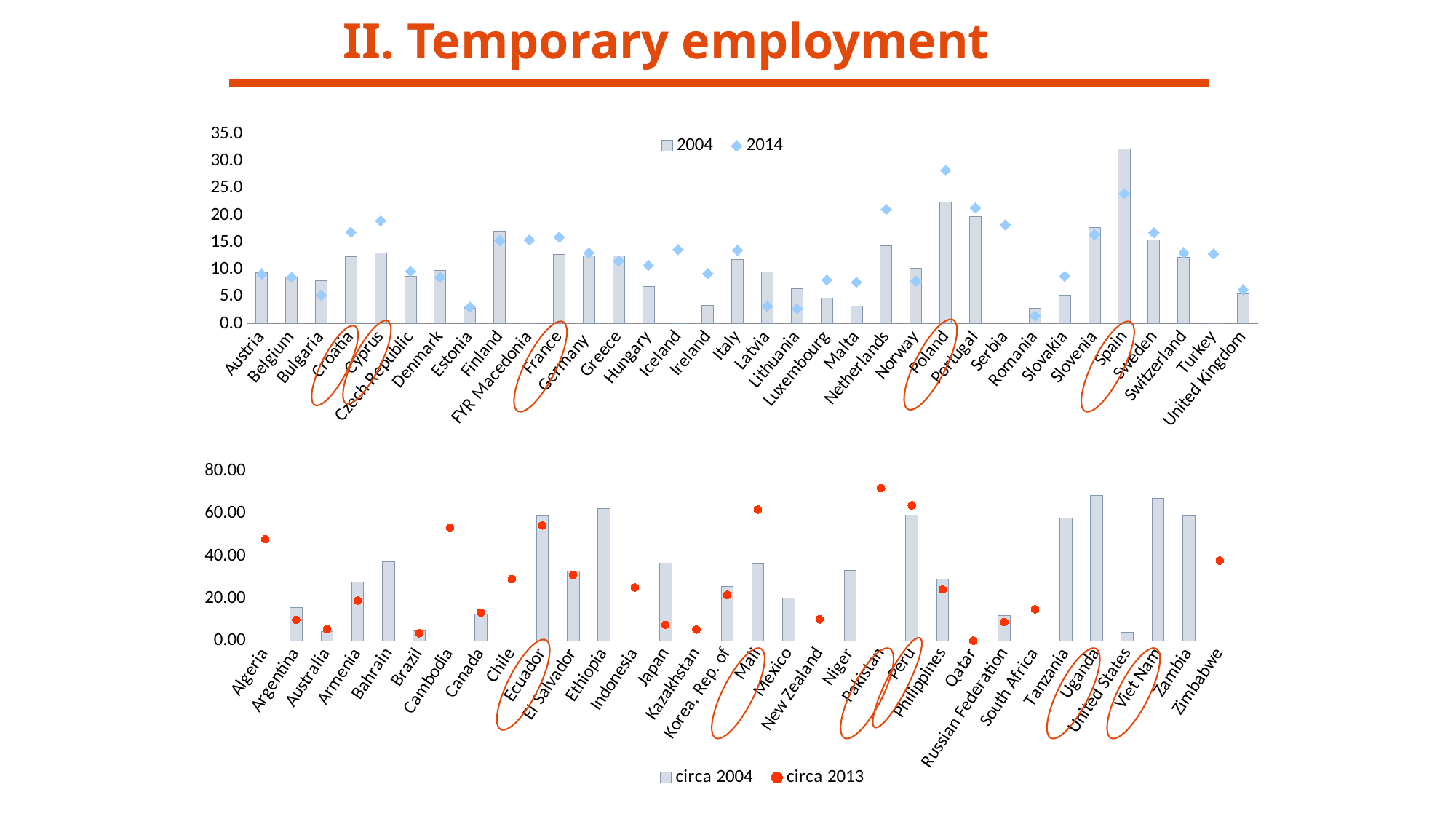
In the top chart, is the 2004 value for Spain greater or less than 30.0? greater In the top chart, which is larger for Poland: the 2004 value or the 2014 value? 2014 In the bottom chart, is the circa 2004 value for Ethiopia greater or less than 40.00? greater In the bottom chart, which country has the lowest circa 2013 value? Qatar In the top chart, is the 2004 value for Hungary greater or less than 10.0? less In the top chart, which country has the highest 2014 value? Poland How many countries are shown on the x axis of the top chart? 34 In the bottom chart, which is larger for Japan: the circa 2004 value or the circa 2013 value? circa 2004 How many series does the legend of the bottom chart list? 2 In the top chart, which country has the highest 2004 bar? Spain In the bottom chart, which country has the highest circa 2013 value? Pakistan In the top chart, which is larger for Spain: the 2004 value or the 2014 value? 2004